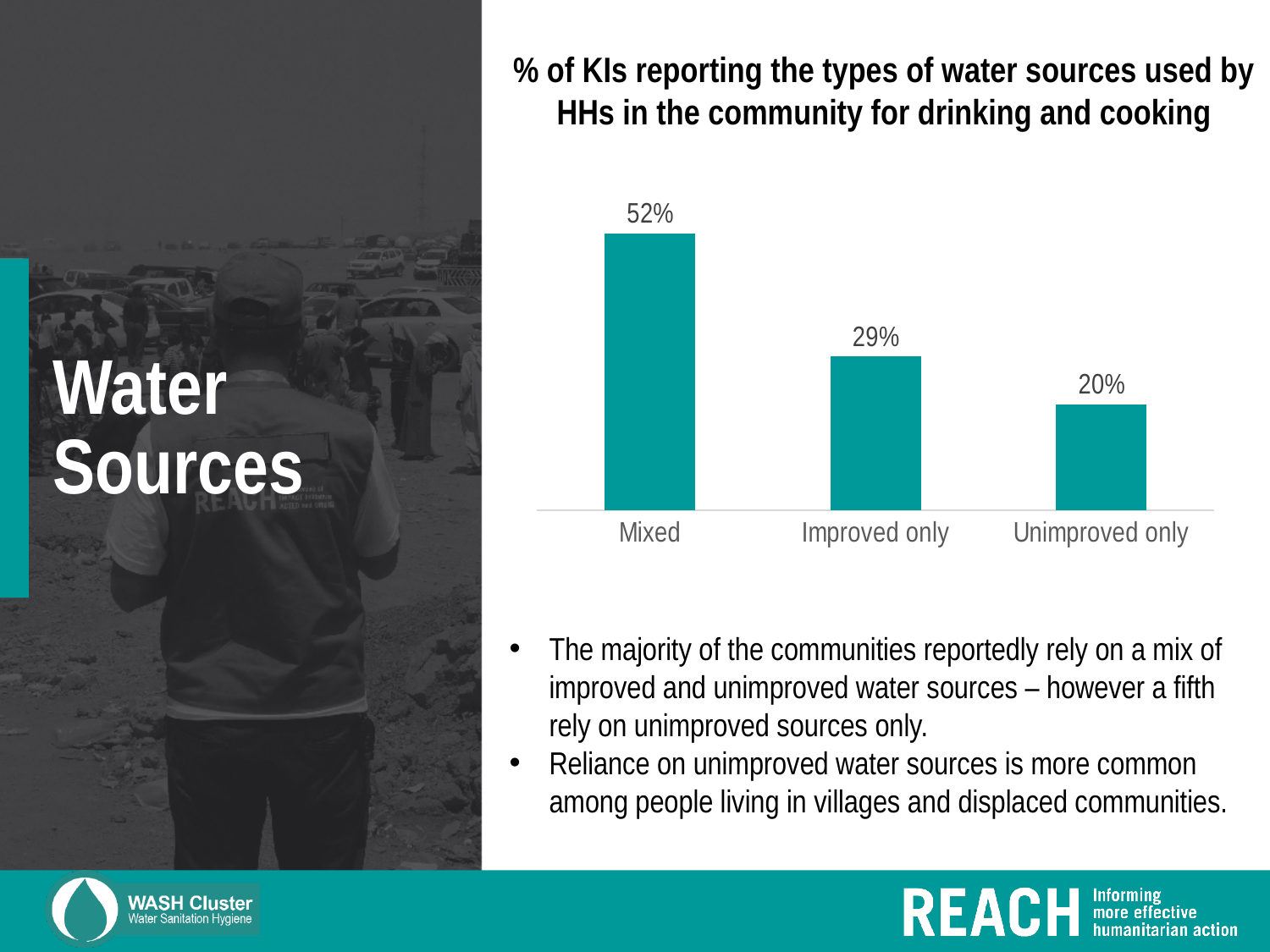
Which water source category has the highest percentage? Mixed What is the value for 'Improved only'? 29% What is the value for 'Unimproved only'? 20% What percentage of KIs reported that households use mixed water sources? 52% Which is larger, the value for 'Improved only' or 'Unimproved only'? Improved only What is the difference in percentage points between 'Improved only' and 'Unimproved only'? 9 What type of chart is shown on the slide? Bar chart Which water source category has the lowest percentage? Unimproved only How many categories are shown in the chart? 3 What is the title of the chart? % of KIs reporting the types of water sources used by HHs in the community for drinking and cooking What is the difference in percentage points between 'Mixed' and 'Improved only'? 23 Do the values rise or fall from left to right across the categories? Fall